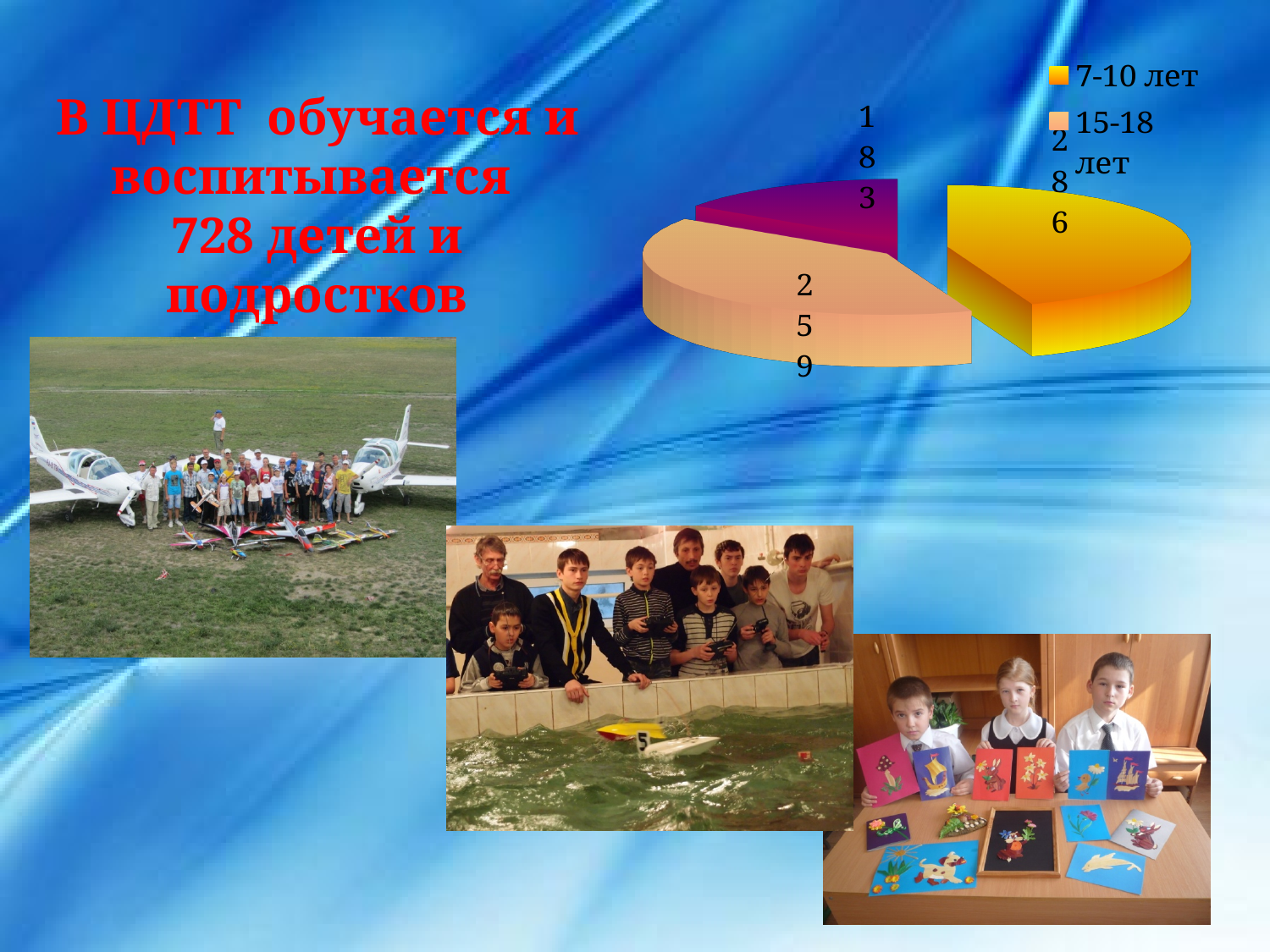
Which of the two legend categories, 7-10 лет or 15-18 лет, has the larger value? 7-10 лет What is the total of all the values shown on the pie chart? 728 What is the difference between the values for 7-10 лет and 15-18 лет? 27 What is the value shown on the purple slice of the pie chart? 183 Which legend category has the largest slice in the pie chart? 7-10 лет How many slices does the pie chart have? 3 What is the value shown for the 15-18 лет slice? 259 What is the value shown for the 7-10 лет slice? 286 What colour is the 7-10 лет slice in the pie chart? yellow What type of chart is shown on the slide? pie chart According to the slide text, how many children and teenagers study at ЦДТТ? 728